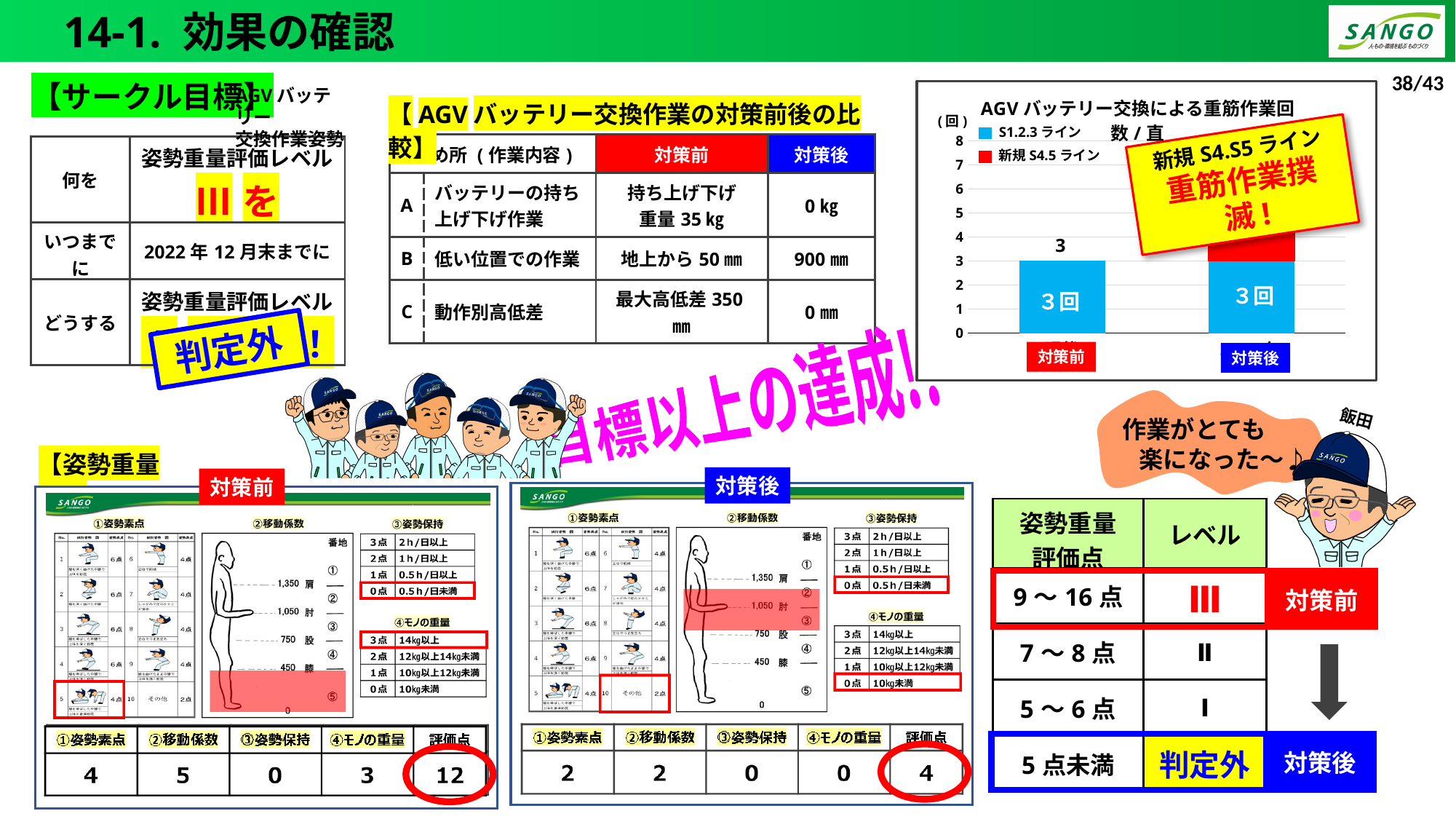
What is the highest tick value shown on the y axis of the bar chart? 8 What kind of chart is shown in the top-right of the slide? bar chart What are the two legend entries of the bar chart? S1.2.3 ライン and 新規 S4.5 ライン In the bar chart, what is the value for S1.2.3 ライン in the 対策前 category? 3回 What colour represents S1.2.3 ライン in the bar chart? blue How many series does the legend of the bar chart list? 2 How many categories are shown on the x axis of the bar chart? 2 In the bar chart, is the value for 対策前 greater or less than 5? less In the bar chart, what is the value for S1.2.3 ライン in the 対策後 category? 3回